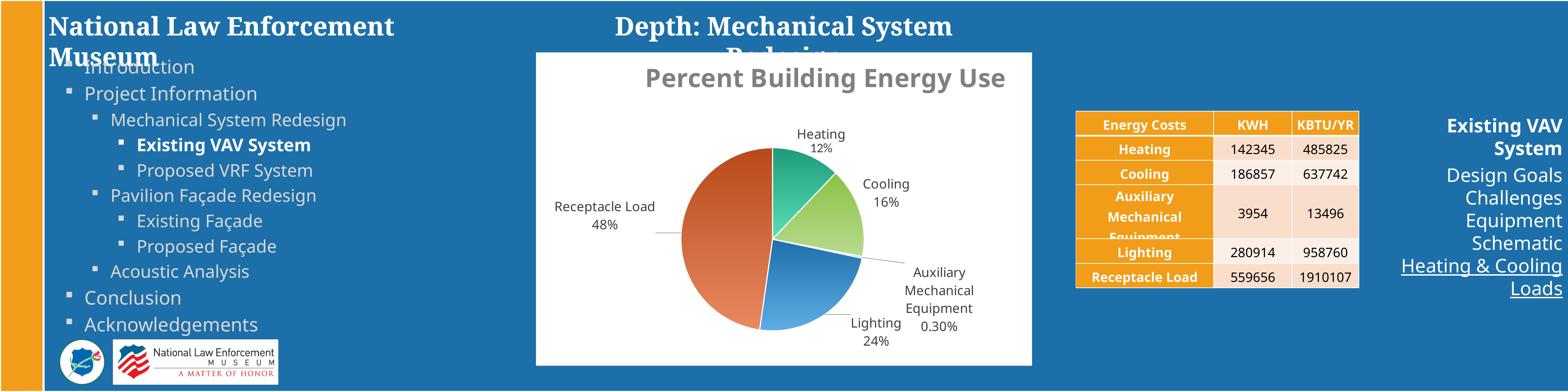
Which category has the largest share of building energy use? Receptacle Load What share of building energy use does Heating account for? 12% Which category has the smallest share of building energy use? Auxiliary Mechanical Equipment What share of building energy use does Lighting account for? 24% What share of building energy use does Receptacle Load account for? 48% Which is larger, the share for Cooling or the share for Heating? Cooling How many slices does the pie chart have? 5 What is the difference in percentage points between Receptacle Load and Lighting? 24 What is the title of the chart? Percent Building Energy Use What kind of chart is shown on the slide? pie chart